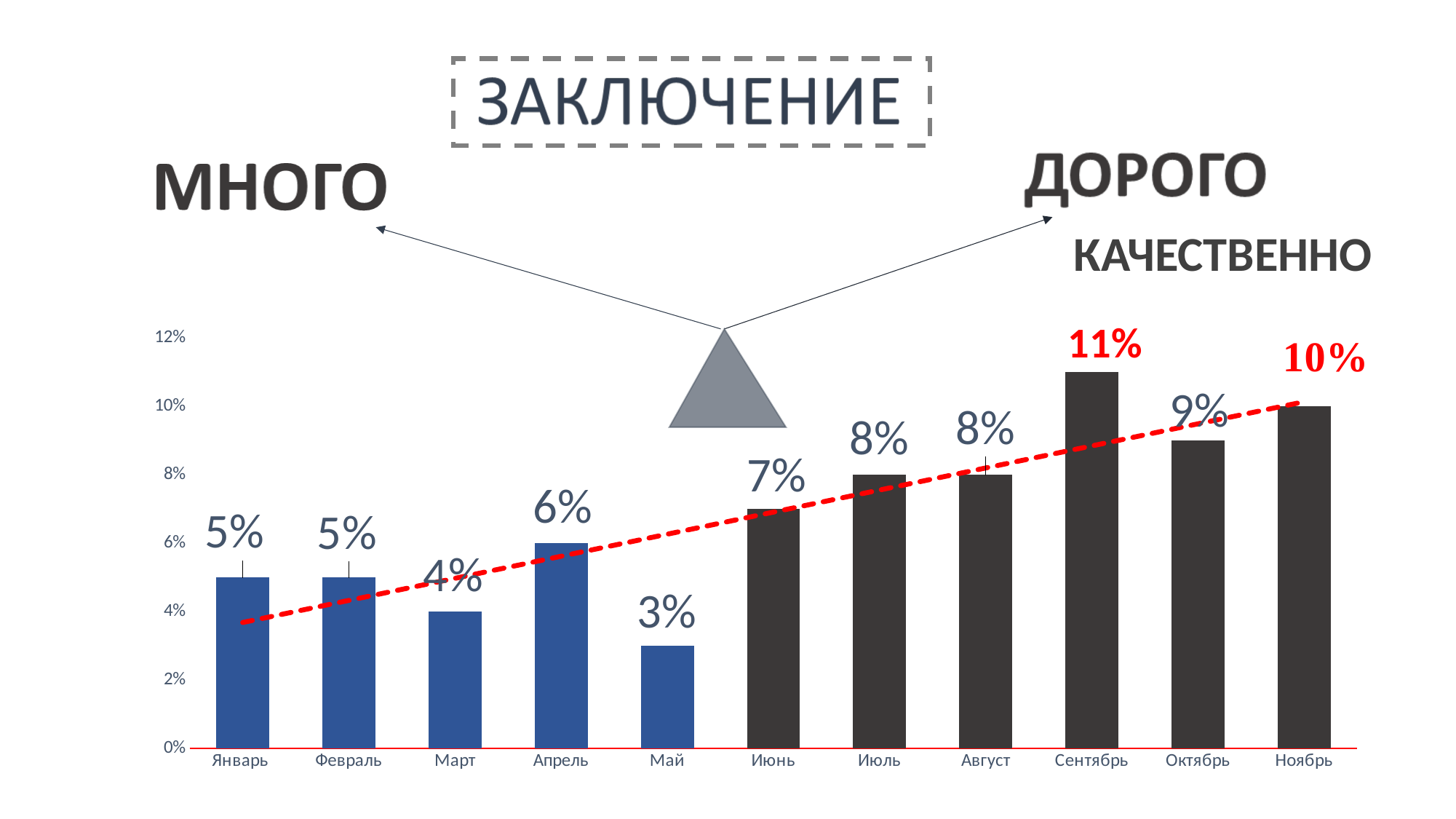
What is the difference between the values for Ноябрь and Январь? 5% What is the value for Ноябрь? 10% What is the value for Сентябрь? 11% What is the difference between the values for Сентябрь and Май? 8% Which month has the highest value? Сентябрь Is the value for Октябрь greater or less than 8%? greater What is the value for Май? 3% How many months are shown on the x axis? 11 What colour are the bars for Январь through Май? blue Which is larger, the value for Апрель or the value for Март? Апрель What kind of chart is shown on the slide? bar chart Which month has the lowest value? Май